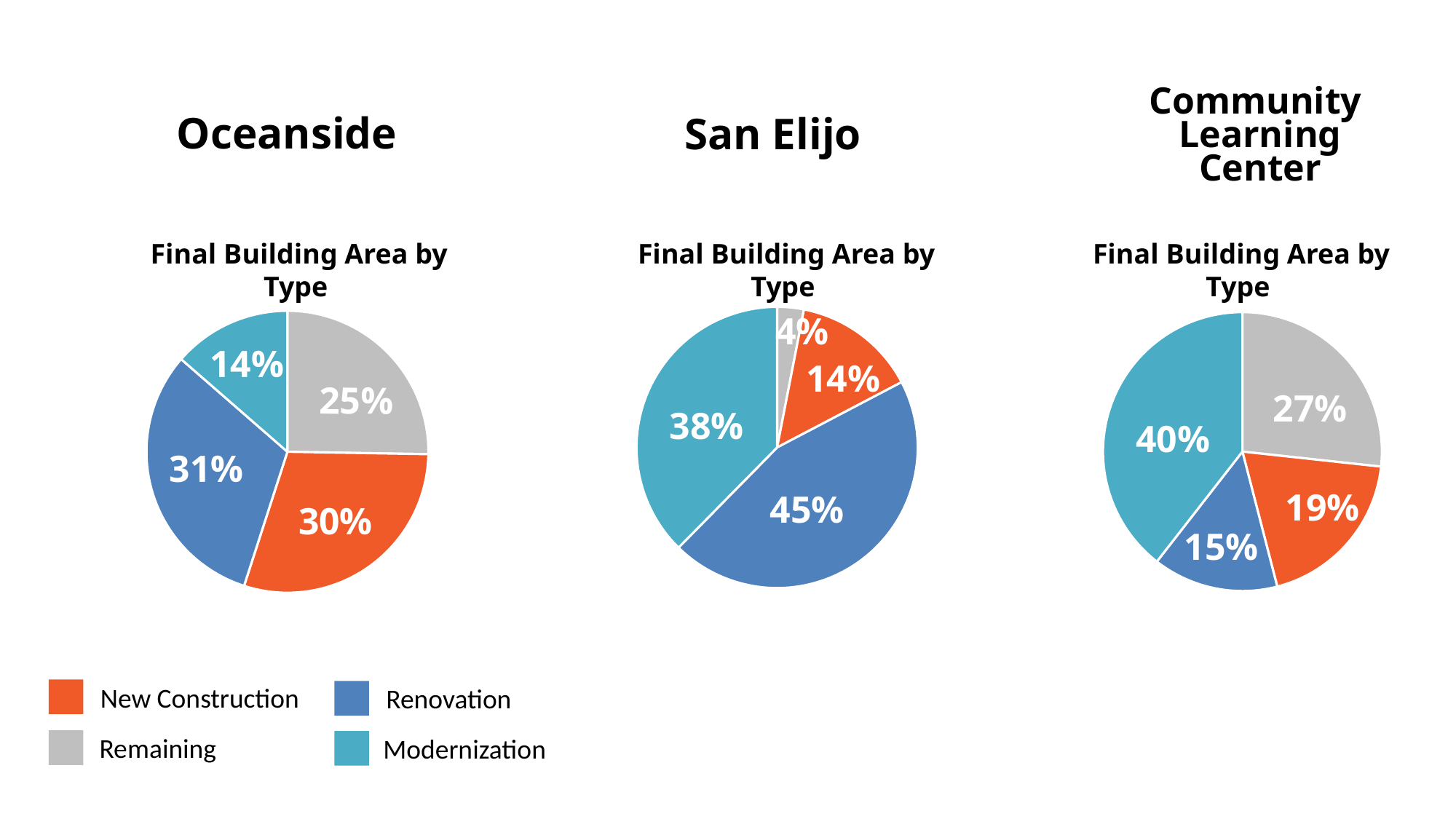
How many entries does the legend list? 4 How many slices does the Oceanside pie chart have? 4 In the Community Learning Center chart, which type has the smallest share? Renovation In the Oceanside chart, what share of the final building area is Renovation? 31% In the Community Learning Center chart, which is larger: the Remaining share or the New Construction share? Remaining What kind of chart is used for the Community Learning Center? Pie chart In the Oceanside chart, which type has the smallest share? Modernization In the San Elijo chart, what share of the final building area is Modernization? 38% In the San Elijo chart, which type has the largest share? Renovation In the Community Learning Center chart, what share of the final building area is New Construction? 19% In the San Elijo chart, what is the difference between the Renovation share and the Modernization share? 7%